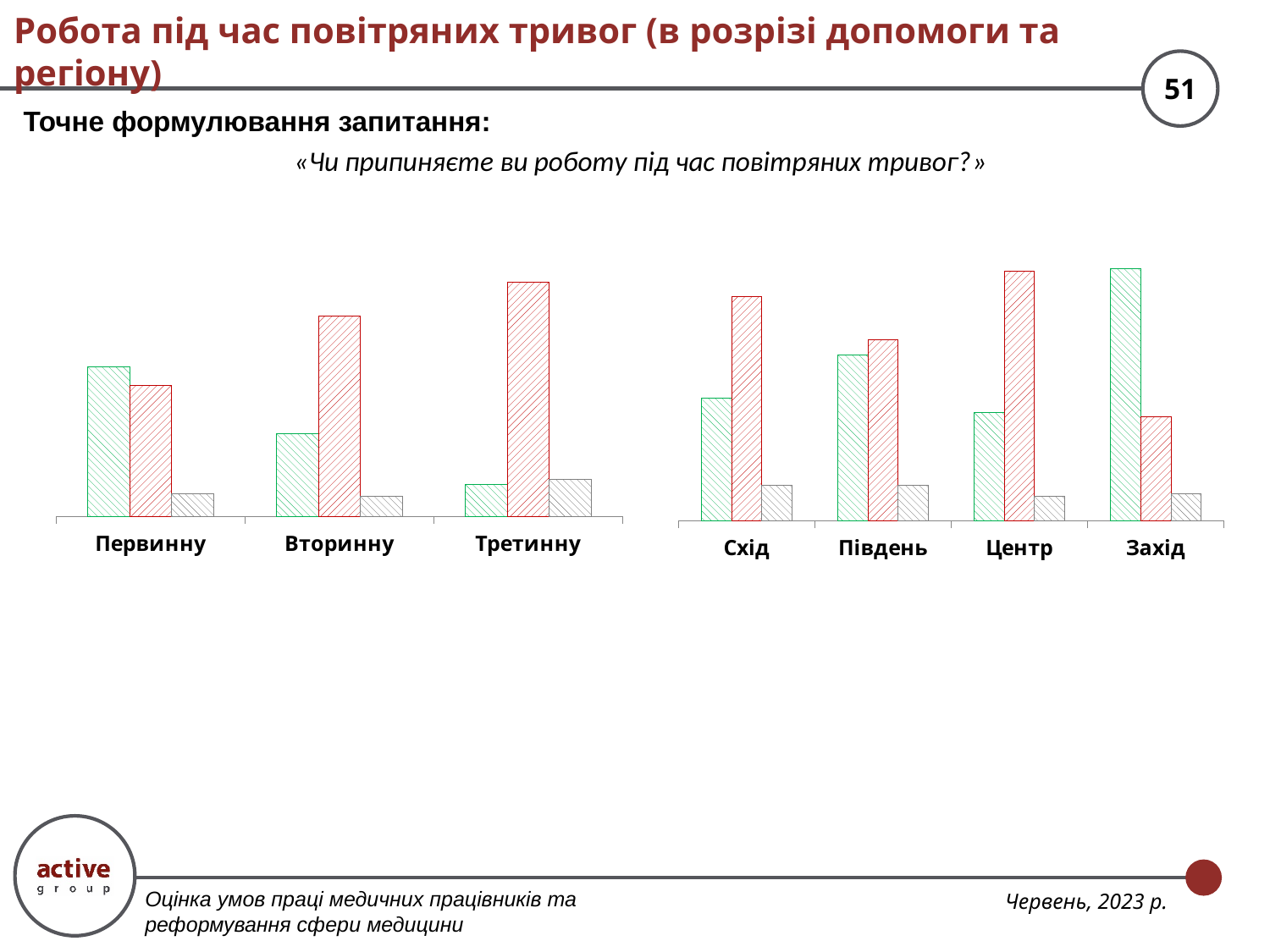
What kind of chart is the left chart (Первинну, Вторинну, Третинну)? bar chart In the right chart, for Захід, which bar is taller: the green hatched bar or the red hatched bar? green hatched bar What kind of chart is the right chart (Схід, Південь, Центр, Захід)? bar chart In the left chart, which category has the shortest green hatched bar? Третинну In the left chart, for Вторинну, which bar is taller: the green hatched bar or the red hatched bar? red hatched bar In the left chart, which category has the tallest red hatched bar? Третинну In the left chart, how many bars are plotted for each category? 3 How many categories are shown on the x axis of the right chart? 4 In the left chart, which category has the tallest green hatched bar? Первинну In the right chart, which category has the tallest red hatched bar? Центр How many categories are shown on the x axis of the left chart? 3